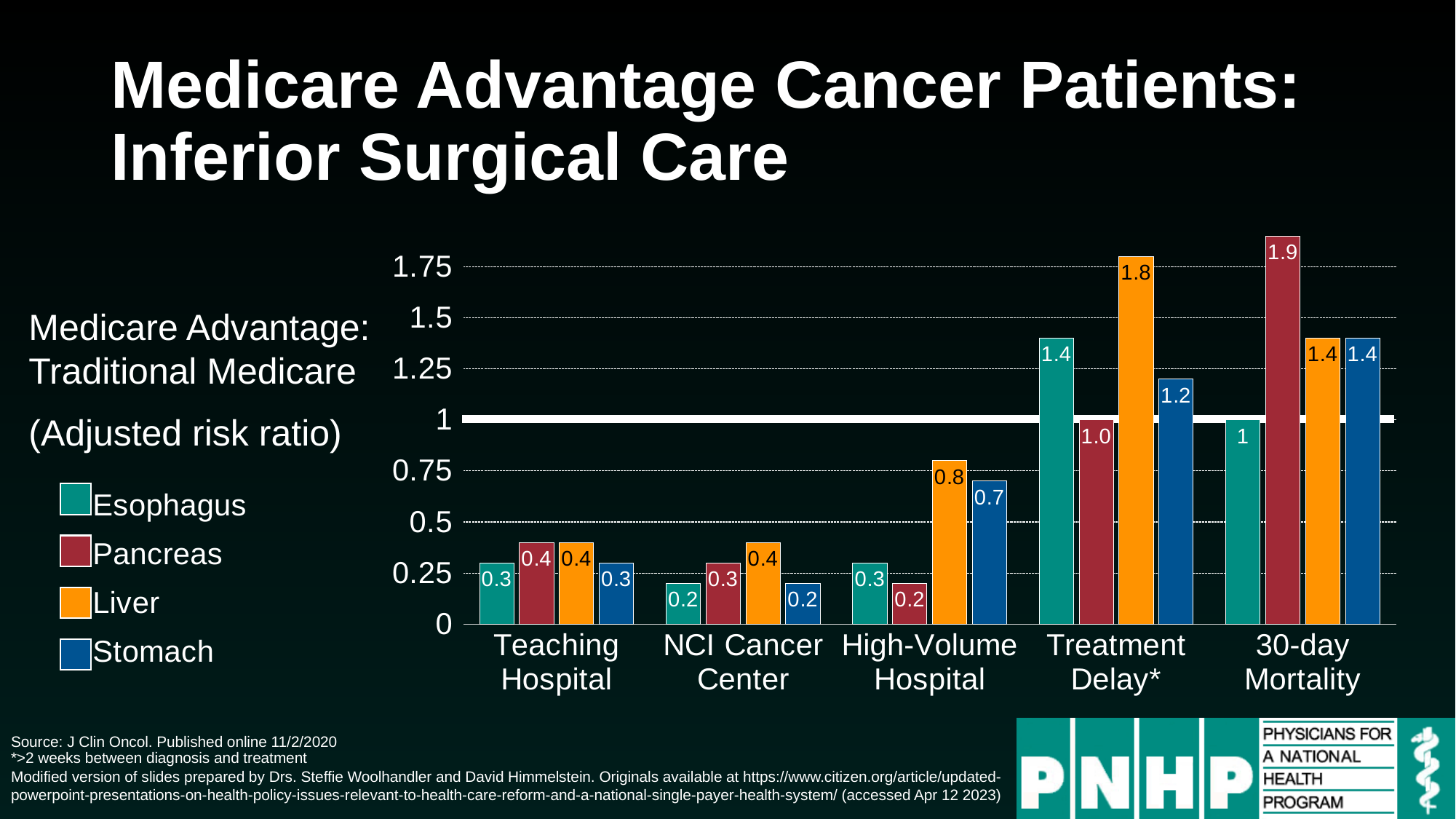
Under High-Volume Hospital, which is larger: the Liver value or the Pancreas value? Liver What is the adjusted risk ratio for Pancreas under 30-day Mortality? 1.9 Is the Stomach value under Treatment Delay* greater or less than 1? greater What is the adjusted risk ratio for Stomach under High-Volume Hospital? 0.7 What kind of chart is shown on the slide? Bar chart How many categories are shown on the x axis? 5 What is the adjusted risk ratio for Esophagus under NCI Cancer Center? 0.2 Which cancer type has the highest adjusted risk ratio under 30-day Mortality? Pancreas What is the difference between the Liver and Esophagus adjusted risk ratios under Treatment Delay*? 0.4 What is the adjusted risk ratio for Liver under Treatment Delay*? 1.8 How many series does the legend list? 4 Which cancer type has the lowest adjusted risk ratio under Treatment Delay*? Pancreas